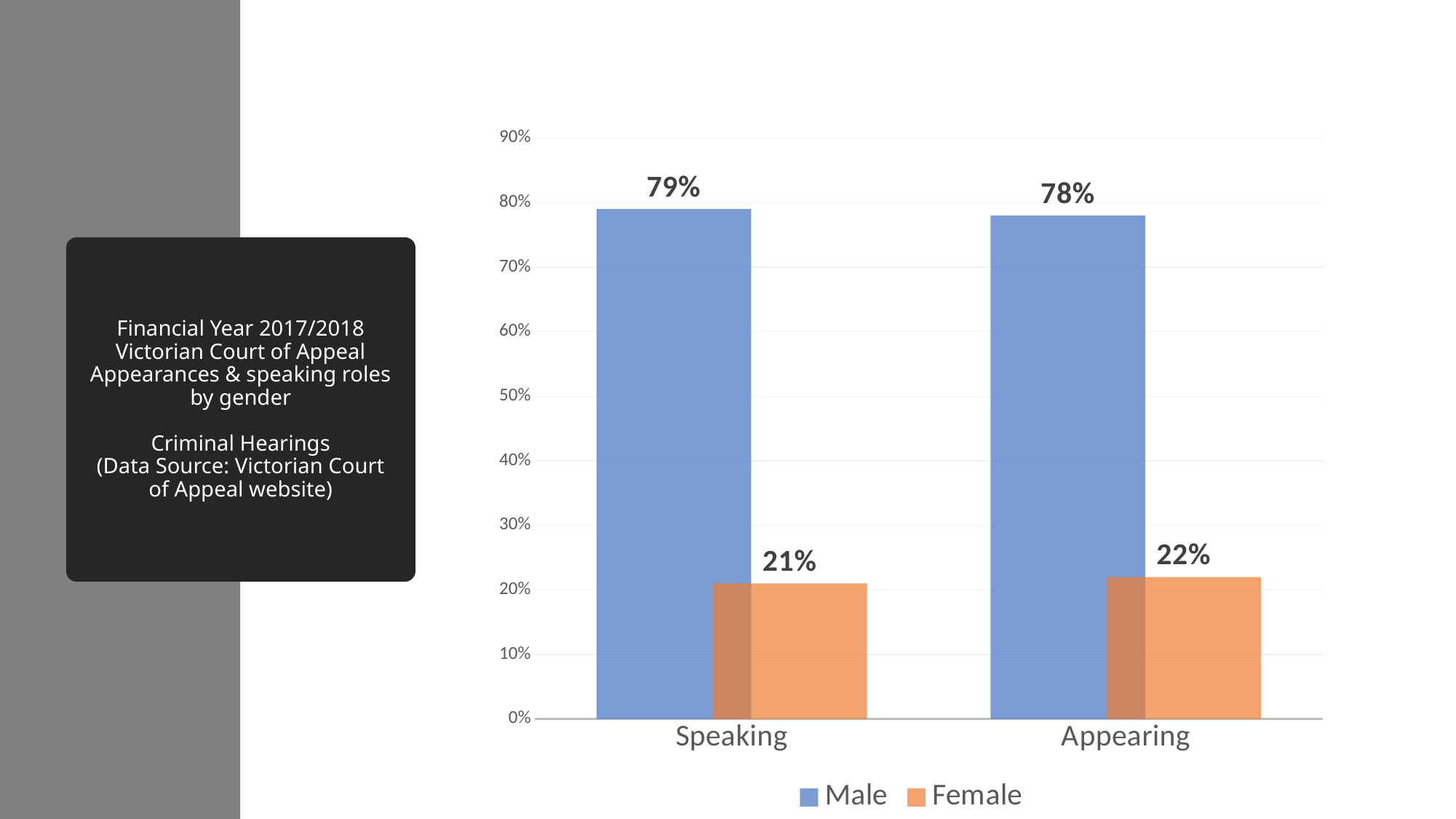
How many categories are shown on the x axis? 2 How many series does the legend list? 2 What is the Female value for Speaking? 21% What kind of chart is shown on the slide? bar chart Is the Male value for Appearing greater or less than the Female value for Appearing? greater What is the Male value for Speaking? 79% What is the Male value for Appearing? 78% What is the Female value for Appearing? 22% Which series has the lowest value for Appearing? Female What is the difference between the Male and Female values for Appearing? 56% What is the difference between the Male and Female values for Speaking? 58% Which series has the highest value for Speaking? Male